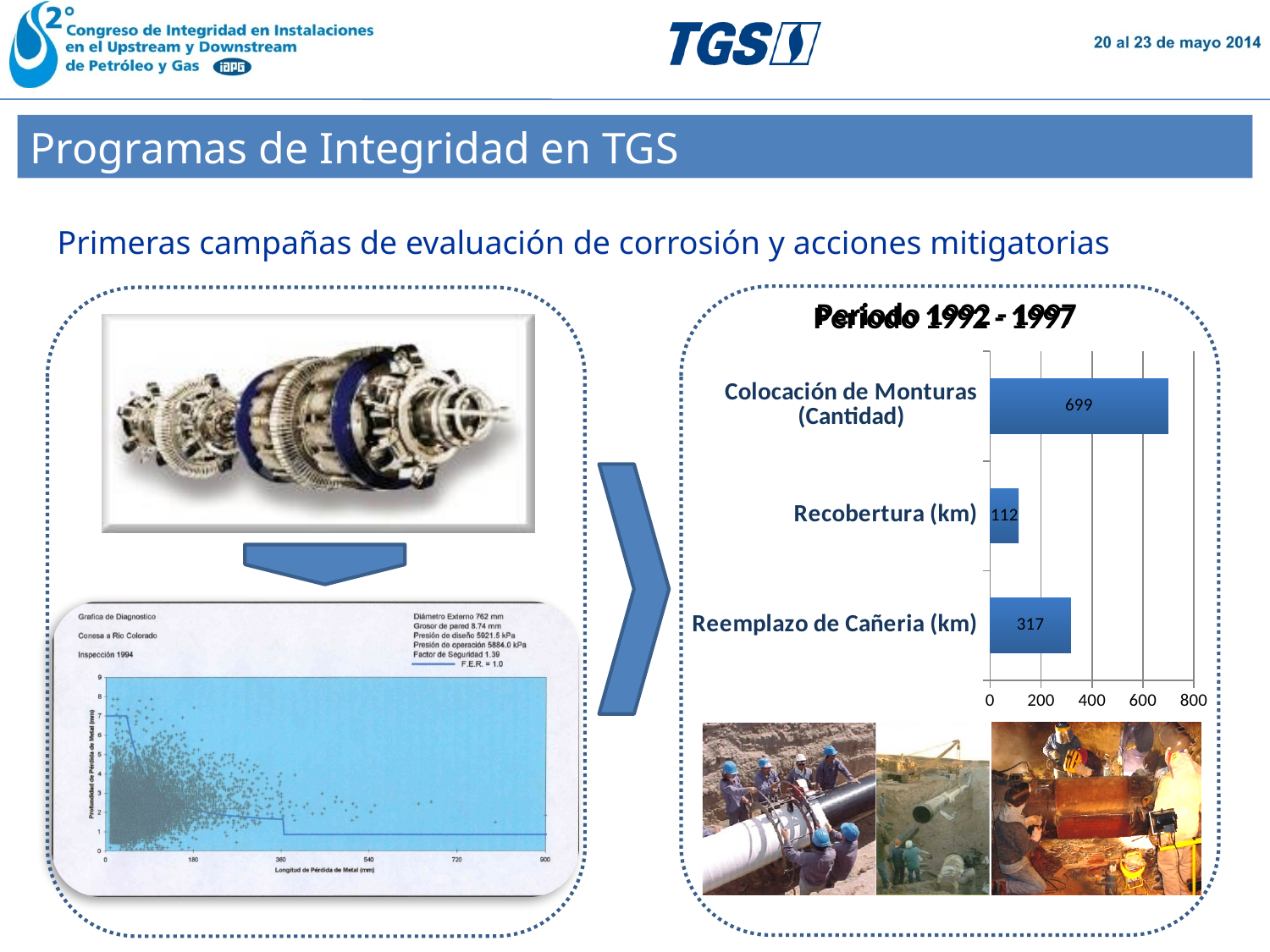
In the 'Periodo 1992 - 1997' chart, what is the value for Colocación de Monturas (Cantidad)? 699 In the 'Periodo 1992 - 1997' chart, is the value for Colocación de Monturas (Cantidad) greater or less than 600? greater In the 'Periodo 1992 - 1997' chart, what is the difference between Colocación de Monturas (Cantidad) and Reemplazo de Cañeria (km)? 382 How many categories are shown in the 'Periodo 1992 - 1997' chart? 3 What kind of chart is the 'Periodo 1992 - 1997' chart? Bar chart In the 'Periodo 1992 - 1997' chart, which category has the highest value? Colocación de Monturas (Cantidad) In the 'Periodo 1992 - 1997' chart, which is larger: Recobertura (km) or Reemplazo de Cañeria (km)? Reemplazo de Cañeria (km) In the 'Periodo 1992 - 1997' chart, what is the difference between Reemplazo de Cañeria (km) and Recobertura (km)? 205 In the 'Periodo 1992 - 1997' chart, which category has the lowest value? Recobertura (km) What is the highest value shown on the horizontal axis of the 'Periodo 1992 - 1997' chart? 800 In the 'Periodo 1992 - 1997' chart, what is the value for Reemplazo de Cañeria (km)? 317 In the 'Periodo 1992 - 1997' chart, what is the value for Recobertura (km)? 112